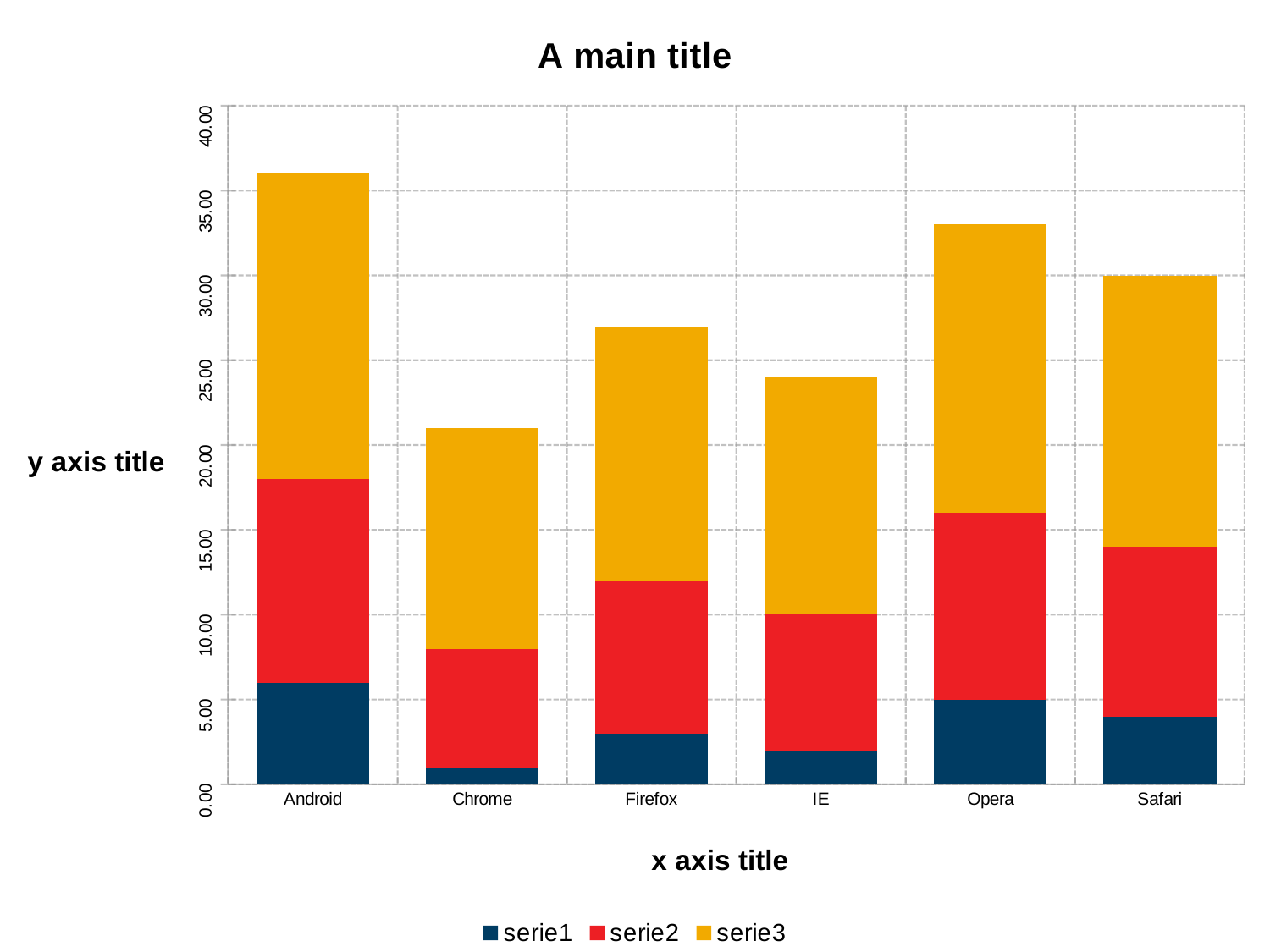
How many categories are shown on the x axis? 6 How many series does the legend list? 3 Which category has the highest total stacked bar? Android Is the total stacked value for Opera greater or less than 30.00? greater Is the total stacked value for Android greater or less than 35.00? greater Which has the larger total stacked bar, Opera or Firefox? Opera What kind of chart is shown on the slide? Stacked bar chart Is the total stacked value for Chrome greater or less than 25.00? less What is the title of the chart? A main title Which series is shown in yellow in the legend? serie3 Which category has the lowest total stacked bar? Chrome